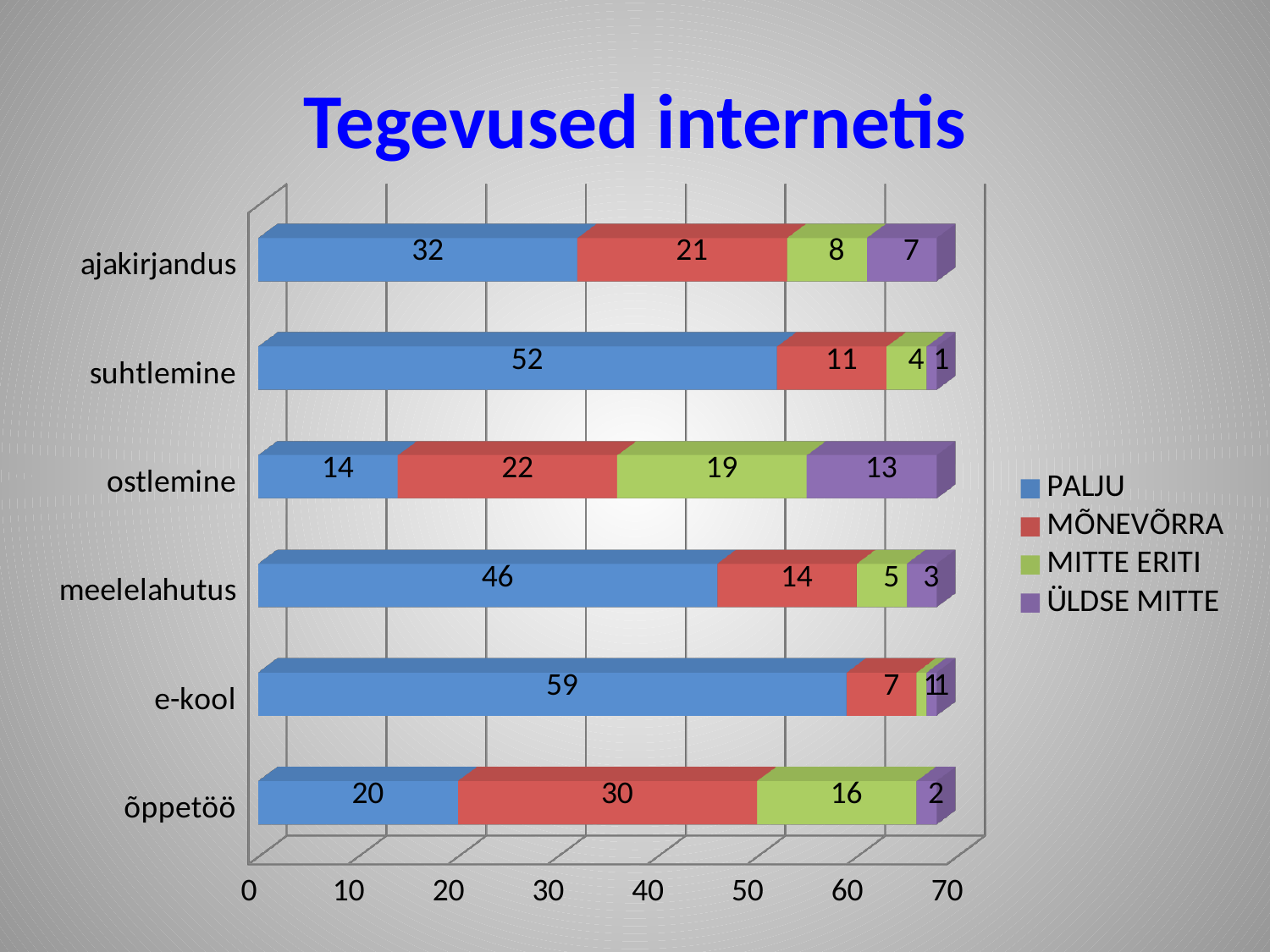
What is the title of the chart? Tegevused internetis Which is larger, the MITTE ERITI value for ostlemine or for õppetöö? ostlemine What is the difference between the PALJU values for e-kool and ajakirjandus? 27 What is the ÜLDSE MITTE value for ostlemine? 13 Which category has the highest PALJU value? e-kool What kind of chart is shown on the slide? stacked bar chart How many series does the legend list? 4 What is the PALJU value for suhtlemine? 52 How many categories are shown on the chart? 6 Which category has the lowest PALJU value? ostlemine What is the MÕNEVÕRRA value for õppetöö? 30 What is the total of the stacked bar for meelelahutus? 68